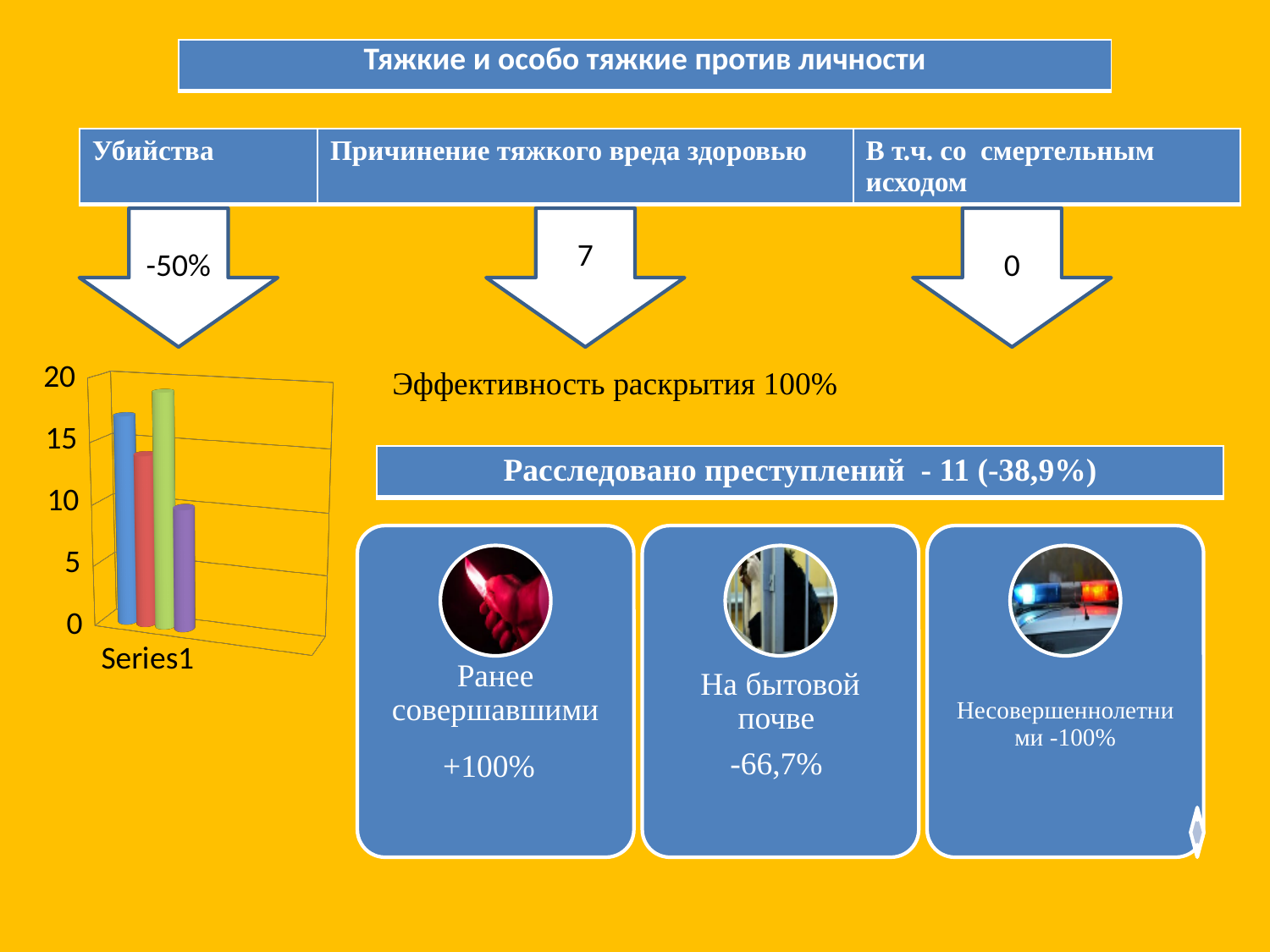
Is the value of the red bar greater or less than 15? less How many bars are plotted in the chart on the left? 4 Is the value of the blue bar greater or less than 15? greater What kind of chart is shown on the left of the slide? bar chart Is the value of the purple bar greater or less than 5? greater What is the category label shown under the bars in the chart? Series1 Which bar is the highest in the chart: the blue, red, green or purple one? green Which is larger in the chart, the blue bar or the red bar? blue Which bar is the lowest in the chart: the blue, red, green or purple one? purple Which is larger in the chart, the red bar or the purple bar? red What is the highest value shown on the vertical axis of the chart? 20